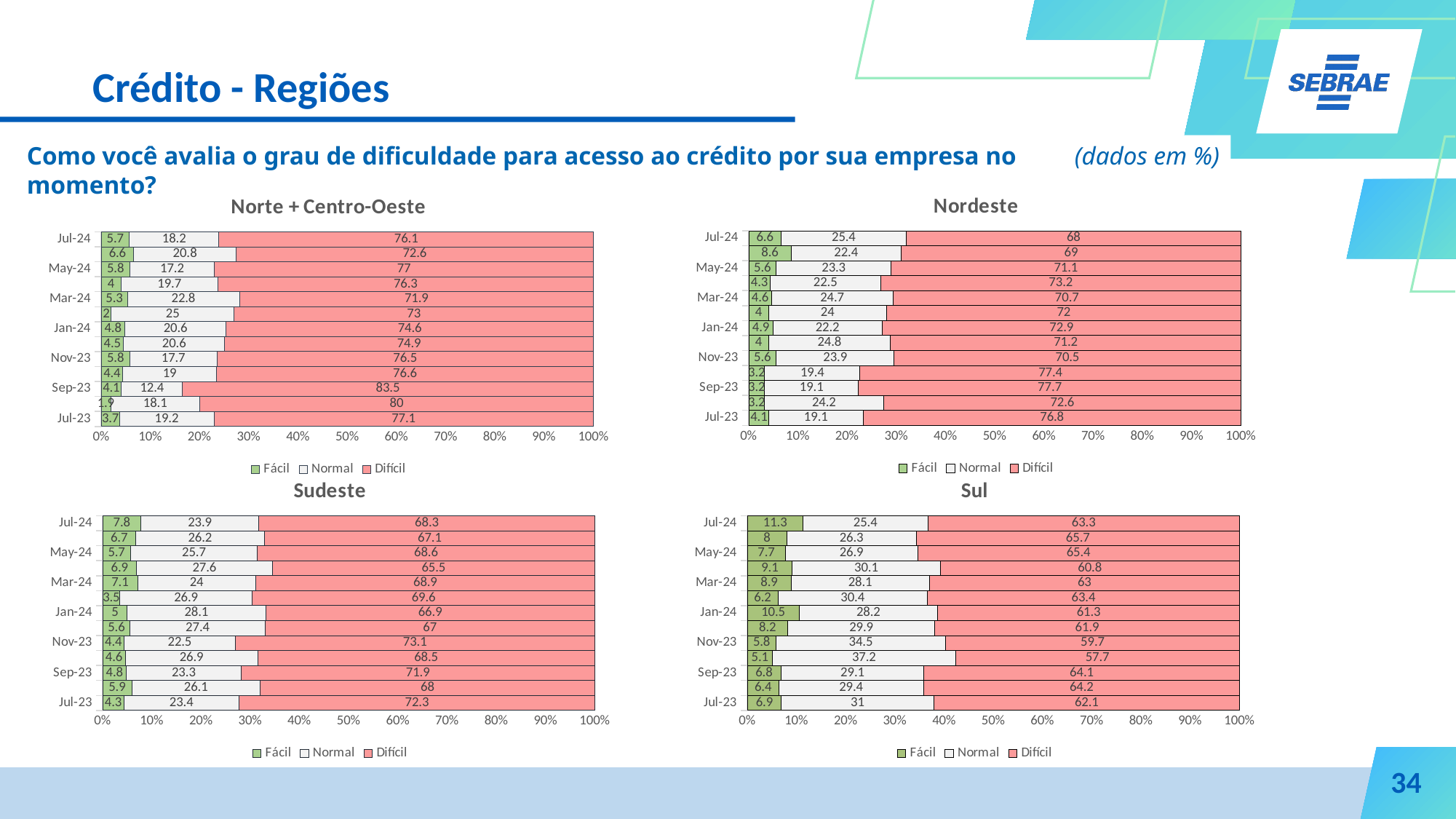
What are the three legend entries shown under each chart? Fácil, Normal, Difícil In the Norte + Centro-Oeste chart, which labelled month has the highest Difícil value? Sep-23 For Jul-24, which chart shows a larger Normal value: Nordeste or Norte + Centro-Oeste? Nordeste In the Sul chart, which labelled month has the highest Fácil value? Jul-24 In the Norte + Centro-Oeste chart, what is the Difícil value for Jul-24? 76.1 What kind of chart is the Nordeste chart? Stacked bar chart In the Sudeste chart, what is the Fácil value for Jul-24? 7.8 In the Sudeste chart, how much higher is the Difícil value for Jul-23 than for Jul-24? 4 In the Sul chart, what is the total of the three segments for Jul-24? 100 In the Sul chart, what is the Difícil value for Nov-23? 59.7 In the Nordeste chart, what is the Normal value for Jul-23? 19.1 How many series does the legend of the Sudeste chart list? 3